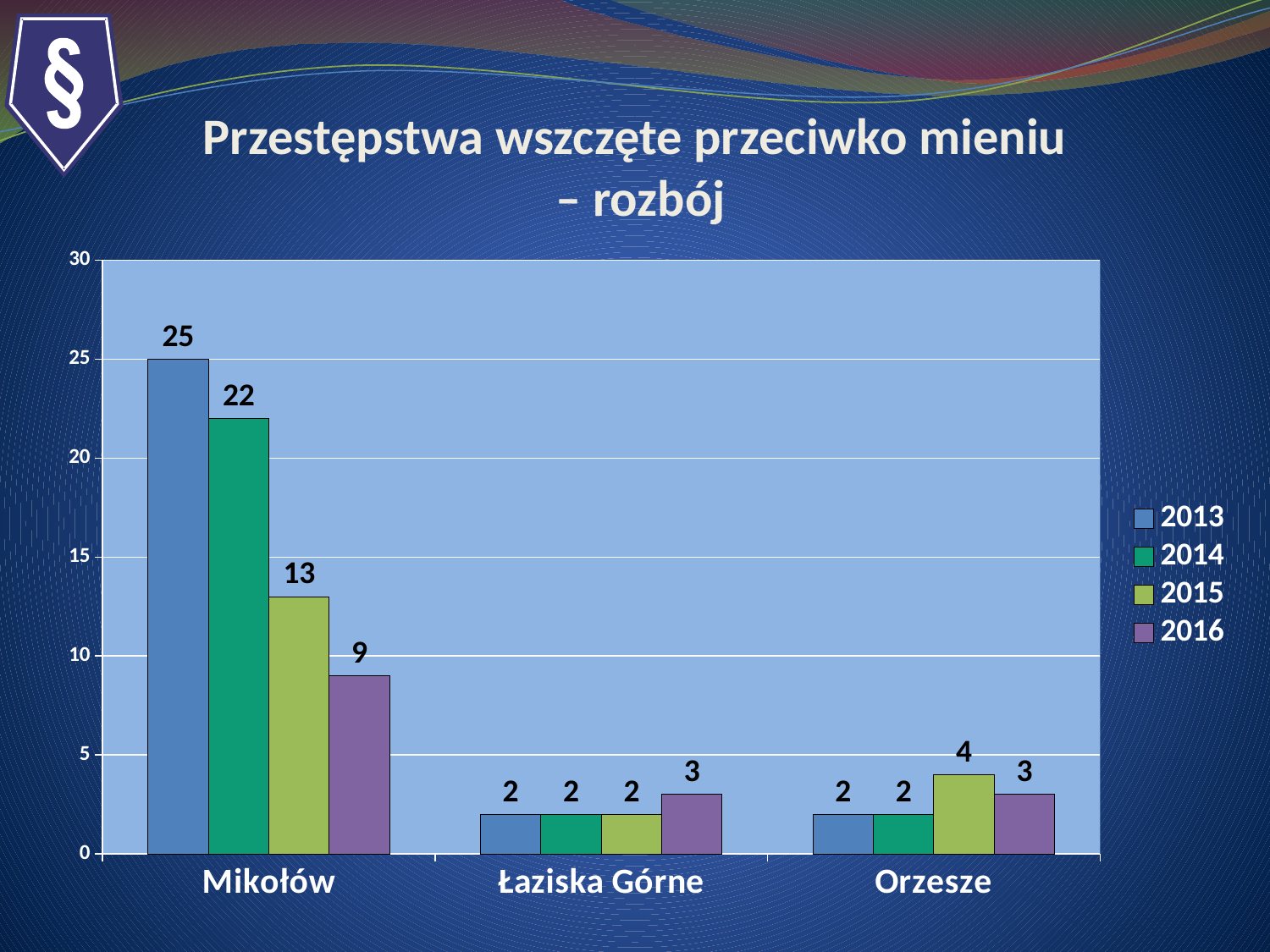
Which year has the lowest value for Mikołów? 2016 Is the value for Mikołów in 2014 greater or less than 20? greater Which category has the highest value in 2014? Mikołów Do the values for Mikołów rise or fall from 2013 to 2016? fall How many series does the legend list? 4 What is the difference between the 2013 and 2016 values for Mikołów? 16 What kind of chart is shown on the slide? bar chart What is the value for Orzesze in 2015? 4 What is the value for Łaziska Górne in 2016? 3 How many categories are shown on the x axis? 3 Which is larger for Orzesze: the 2015 value or the 2016 value? 2015 What is the value for Mikołów in 2013? 25